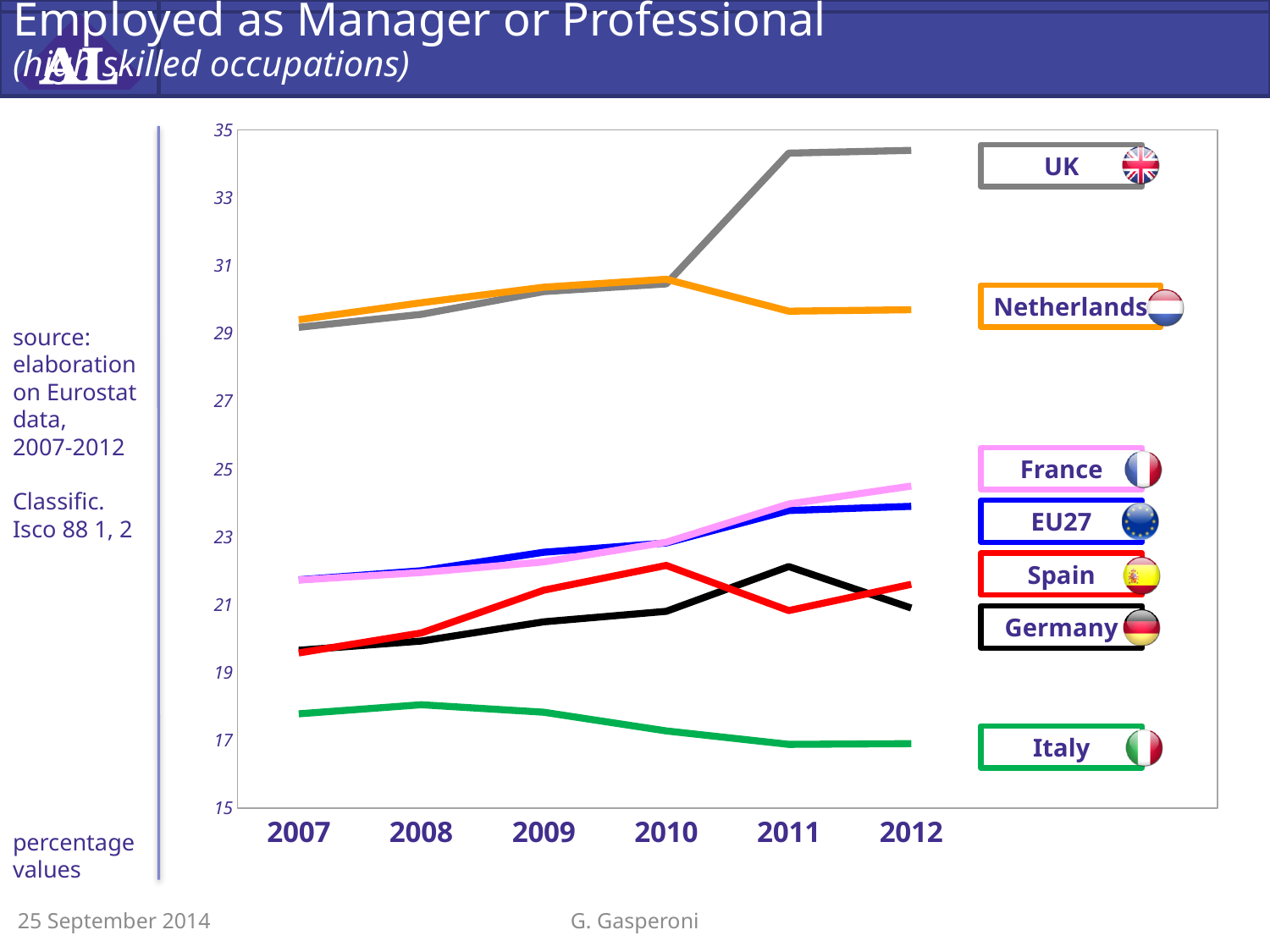
Does the value for Italy rise or fall from 2007 to 2012? fall Which series has the lowest value in 2012? Italy Is the value for the UK in 2012 greater or less than 33? greater How many years are plotted along the x axis? 6 Does the value for the UK rise or fall from 2007 to 2012? rise Which series has the highest value in 2012? UK Is the value for Italy in 2007 greater or less than 19? less How many countries/series are shown in the chart? 7 Is the value for the Netherlands in 2012 greater or less than 31? less In 2011, which is larger: the value for Germany or the value for Spain? Germany What kind of chart is shown on the slide? line chart